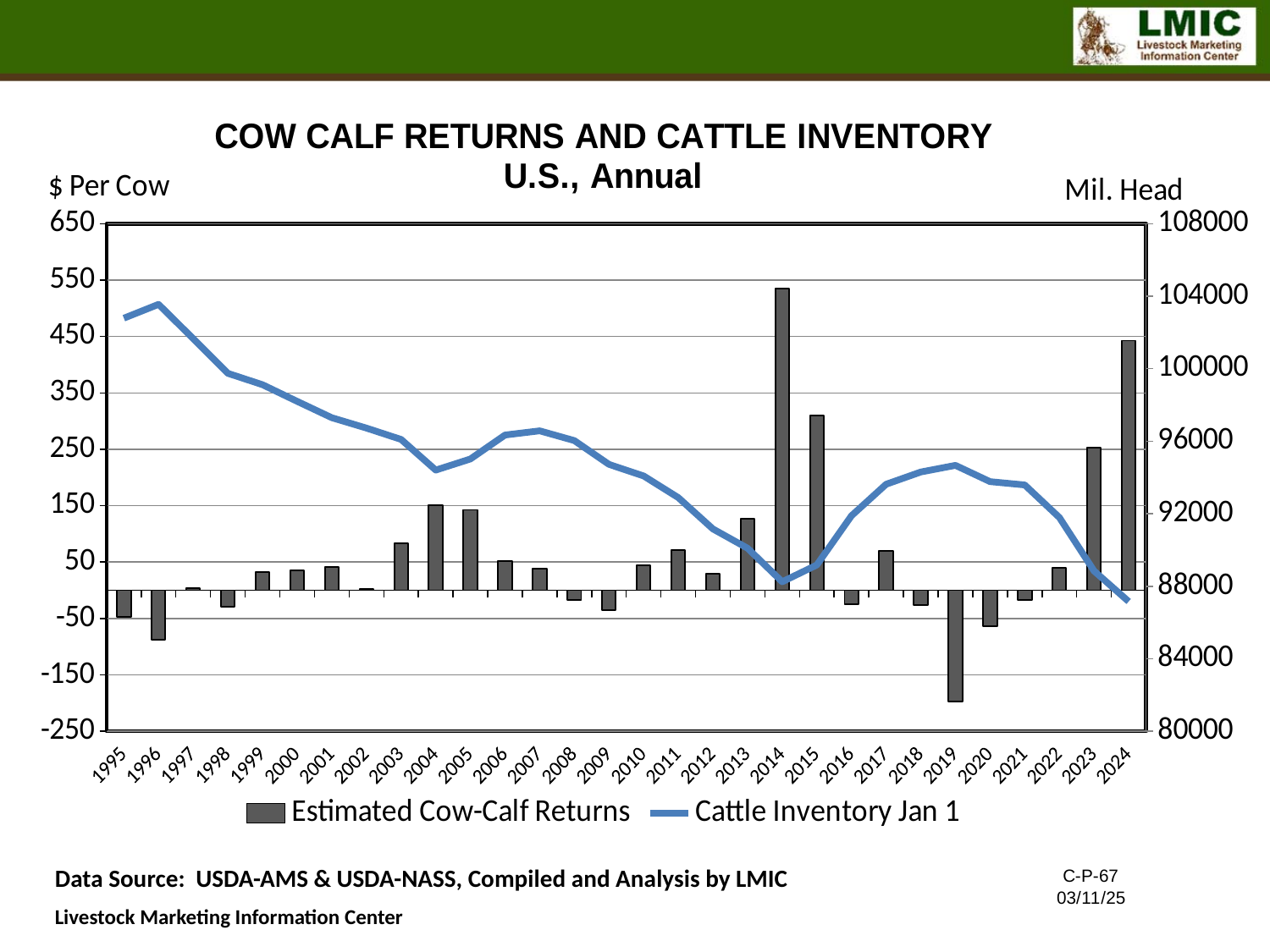
Is the Estimated Cow-Calf Returns value for 2019 greater or less than -150? less What is the label of the right-hand vertical axis? Mil. Head Is the Cattle Inventory Jan 1 value for 1996 greater or less than 100000? greater Is the Estimated Cow-Calf Returns value for 2014 greater or less than 450? greater How many years are shown on the x axis? 30 Which year has the larger Estimated Cow-Calf Returns bar, 2014 or 2015? 2014 In which year is the Estimated Cow-Calf Returns bar the highest? 2014 How many series does the legend list? 2 What kind of chart is shown on the slide? A combination bar and line chart Does the Cattle Inventory Jan 1 line rise or fall from 1996 to 2014? fall In which year is the Estimated Cow-Calf Returns bar the lowest? 2019